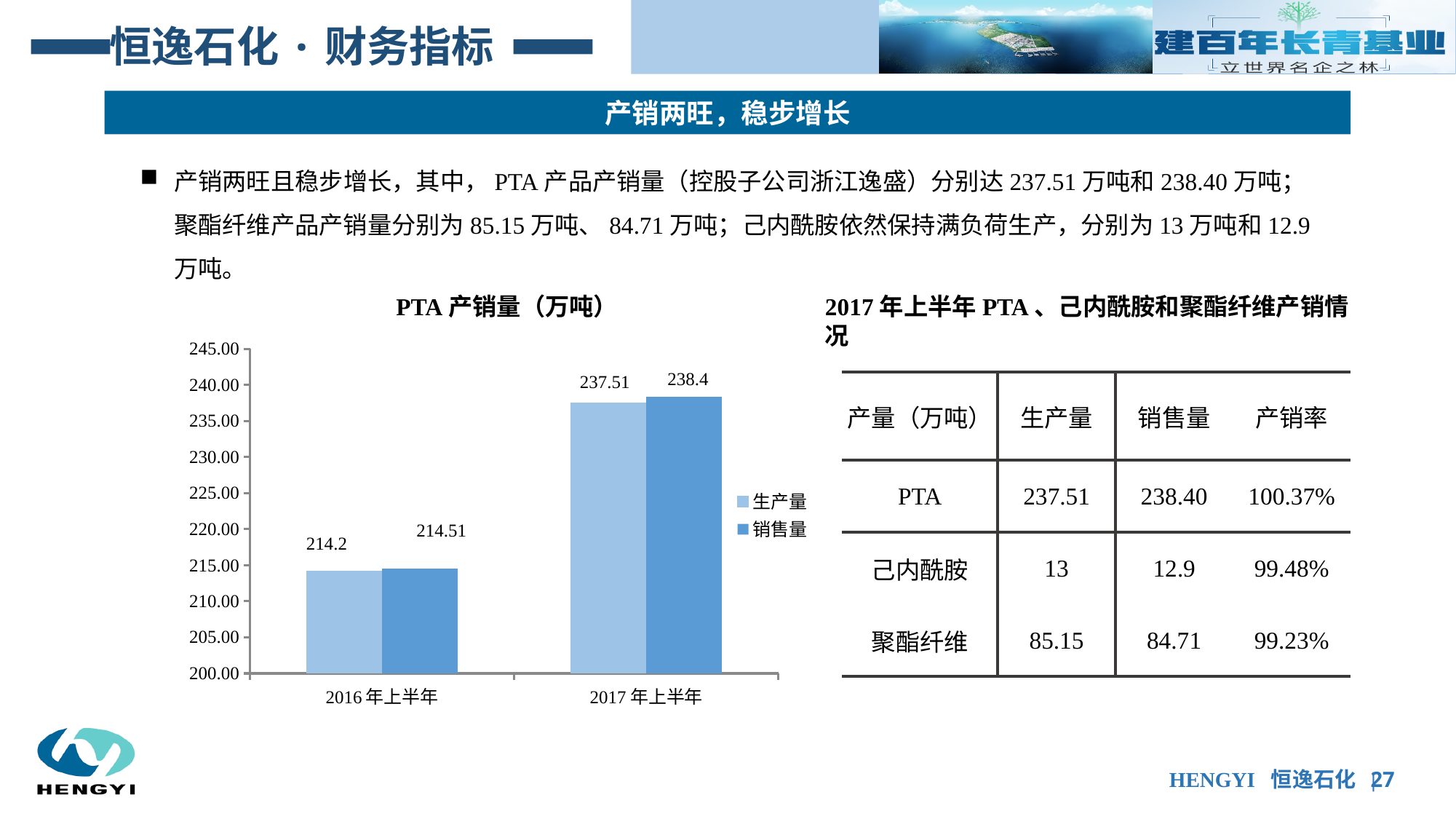
What is the difference in 生产量 between 2017年上半年 and 2016年上半年 in the PTA 产销量 chart? 23.31 What is the 销售量 value for 2016年上半年 in the PTA 产销量 chart? 214.51 Does the 销售量 rise or fall from 2016年上半年 to 2017年上半年 in the PTA 产销量 chart? rise How many series does the legend of the PTA 产销量 chart list? 2 What is the 生产量 value for 2016年上半年 in the PTA 产销量 chart? 214.2 How many periods are shown on the x axis of the PTA 产销量 chart? 2 Which period has the higher 生产量 in the PTA 产销量 chart? 2017年上半年 Which period has the lowest 销售量 in the PTA 产销量 chart? 2016年上半年 Is the 销售量 for 2017年上半年 greater or less than 235.00 in the PTA 产销量 chart? greater What is the 生产量 value for 2017年上半年 in the PTA 产销量 chart? 237.51 What is the 销售量 value for 2017年上半年 in the PTA 产销量 chart? 238.4 What type of chart is the PTA 产销量 chart? bar chart